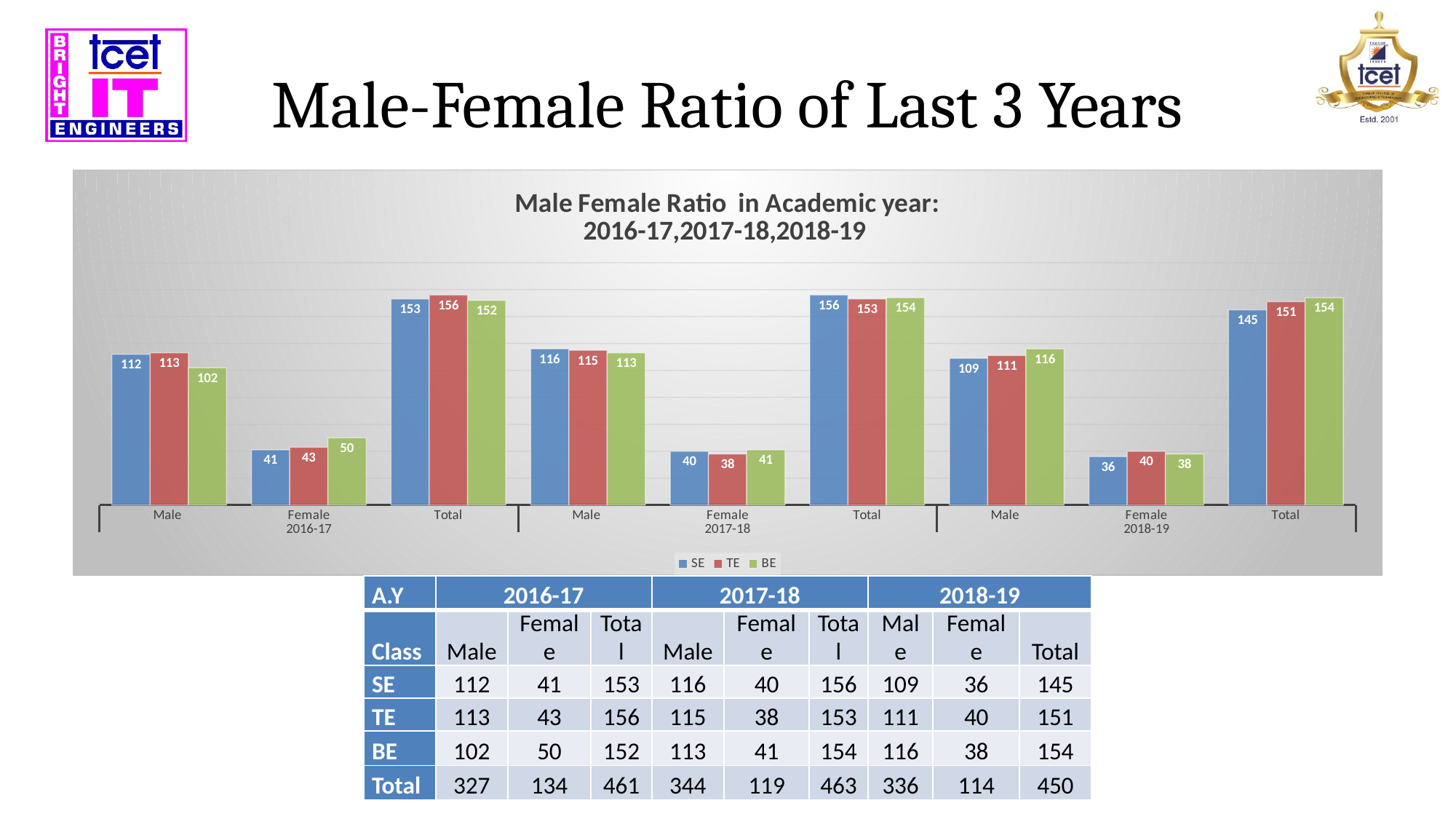
What is the BE value for Female in 2016-17? 50 Which series has the lowest value for Male in 2016-17? BE How many category groups (Male, Female, Total across all years) are shown on the x axis? 9 What is the title of the chart? Male Female Ratio in Academic year: 2016-17,2017-18,2018-19 What is the TE value for Total in 2017-18? 153 What is the difference between the SE Male value and the SE Female value in 2017-18? 76 What is the SE value for Male in 2016-17? 112 Which is larger, the BE value for Male in 2018-19 or the BE value for Male in 2017-18? Male in 2018-19 How many series does the legend list? 3 What is the SE value for Female in 2018-19? 36 What kind of chart is shown on the slide? Bar chart Which series has the highest value for Total in 2016-17? TE